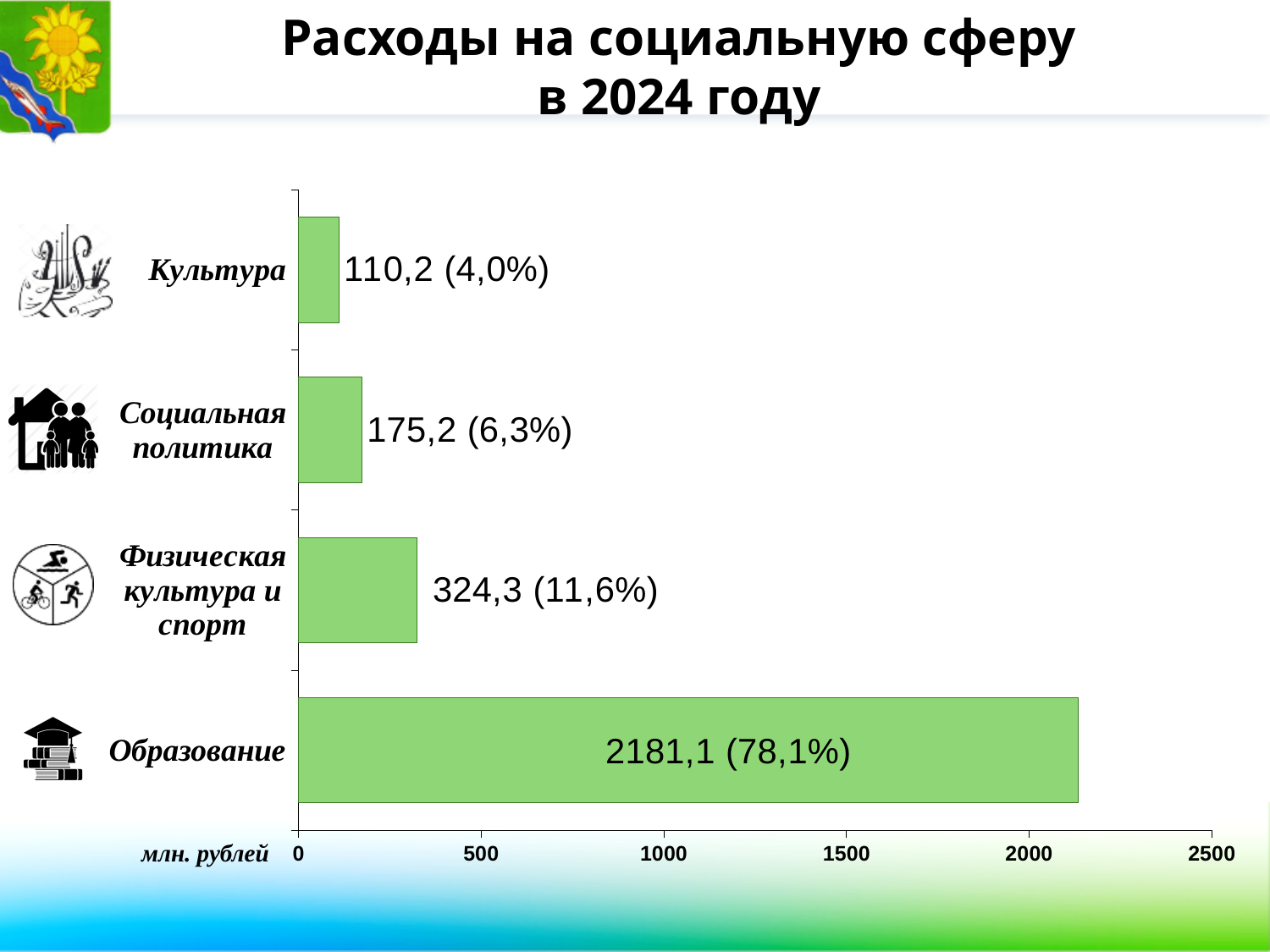
What is the value for Культура? 110,2 Which category has the highest value? Образование Which is larger, the value for Социальная политика or the value for Культура? Социальная политика Is the value for Образование greater or less than 2000? greater What unit is indicated for the values on the chart? млн. рублей What kind of chart is shown on the slide? bar chart How many categories are shown in the chart? 4 Which category has the lowest value? Культура What is the value for Образование? 2181,1 What percentage share is shown for Физическая культура и спорт? 11,6% What is the value for Социальная политика? 175,2 What is the difference between the values for Физическая культура и спорт and Социальная политика? 149,1